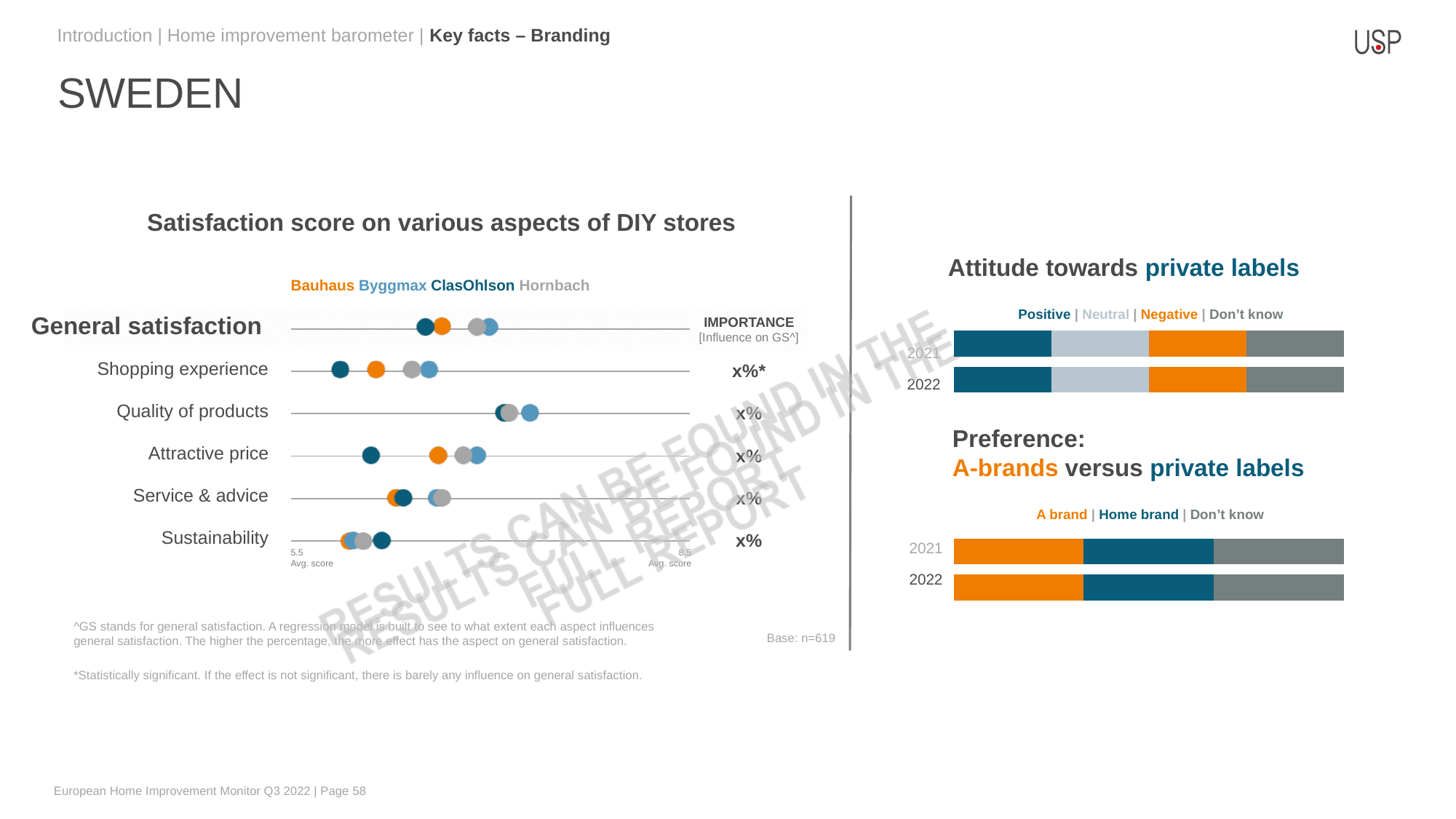
Which years are shown in the 'Attitude towards private labels' chart? 2021 and 2022 How many aspects (rows) are plotted in the 'Satisfaction score on various aspects of DIY stores' chart, including General satisfaction? 6 In the 'Satisfaction score on various aspects of DIY stores' chart, is the Quality of products score for Byggmax greater or less than 8.5? less In the 'Satisfaction score on various aspects of DIY stores' chart, which brand has the lowest score for Shopping experience? ClasOhlson How many categories does the legend of the 'Preference: A-brands versus private labels' chart list? 3 What kind of chart is 'Satisfaction score on various aspects of DIY stores'? Dot plot In the 'Satisfaction score on various aspects of DIY stores' chart, which brand has the lowest score for Attractive price? ClasOhlson What kind of chart is 'Attitude towards private labels'? Stacked bar chart How many DIY store brands does the legend of the 'Satisfaction score on various aspects of DIY stores' chart list? 4 How many categories does the legend of the 'Attitude towards private labels' chart list? 4 What is the base (sample size) stated for the charts on this slide? n=619 In the 'Satisfaction score on various aspects of DIY stores' chart, what are the minimum and maximum values shown on the average score axis? 5.5 and 8.5